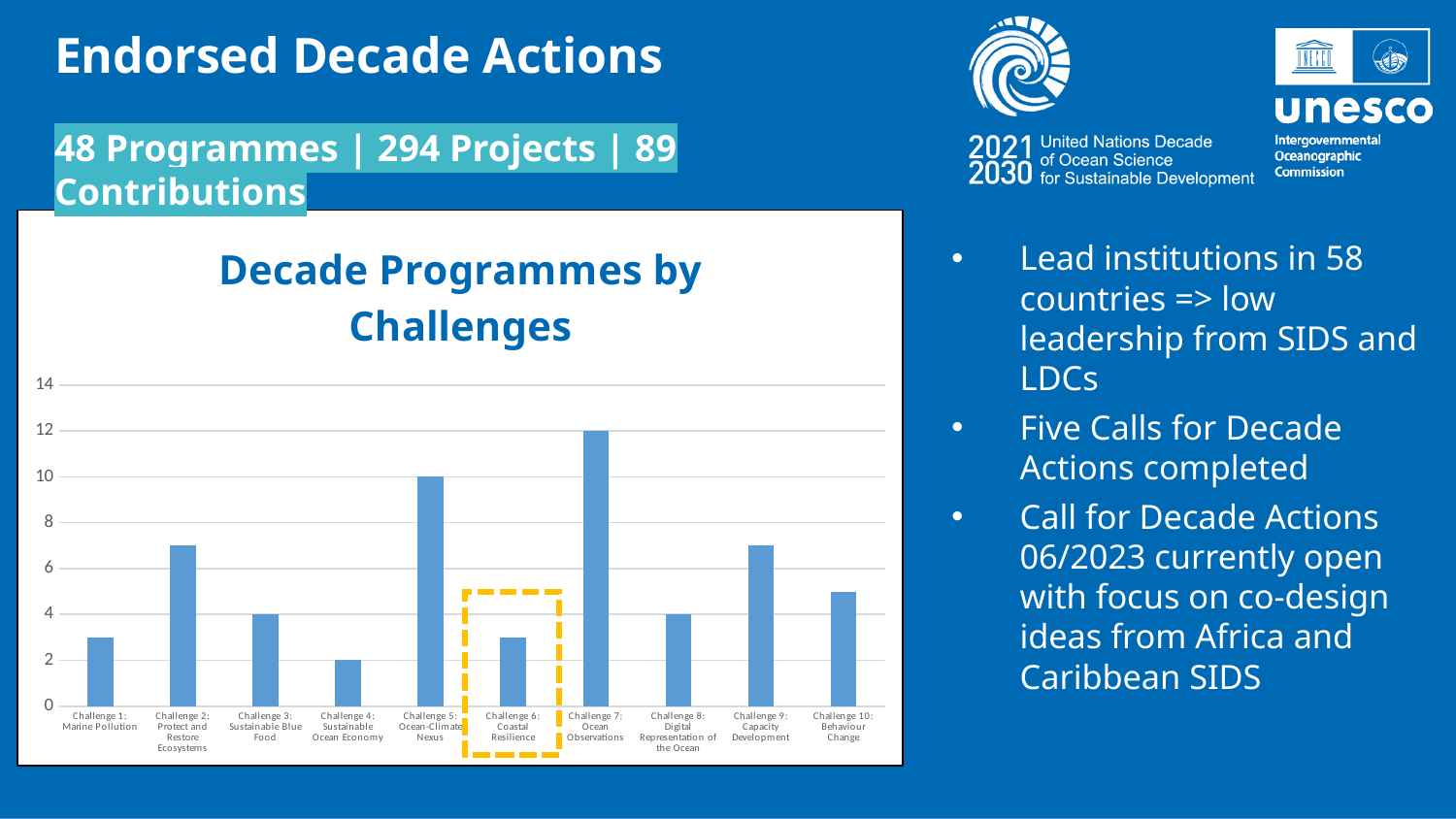
Which challenge has the lowest number of Decade Programmes? Challenge 4: Sustainable Ocean Economy How many Decade Programmes are shown for Challenge 7: Ocean Observations? 12 How many Decade Programmes are shown for Challenge 5: Ocean-Climate Nexus? 10 How many Decade Programmes are shown for Challenge 4: Sustainable Ocean Economy? 2 Which challenge has the highest number of Decade Programmes? Challenge 7: Ocean Observations Which challenge's bar is highlighted with a dashed box on the chart? Challenge 6: Coastal Resilience Is the value for Challenge 2: Protect and Restore Ecosystems greater or less than 6? greater How many challenges are shown on the x axis of the chart? 10 What type of chart is shown on the slide? Bar chart What is the title of the chart? Decade Programmes by Challenges What is the difference between the number of programmes for Challenge 7 and Challenge 5? 2 Which has more Decade Programmes, Challenge 5: Ocean-Climate Nexus or Challenge 9: Capacity Development? Challenge 5: Ocean-Climate Nexus